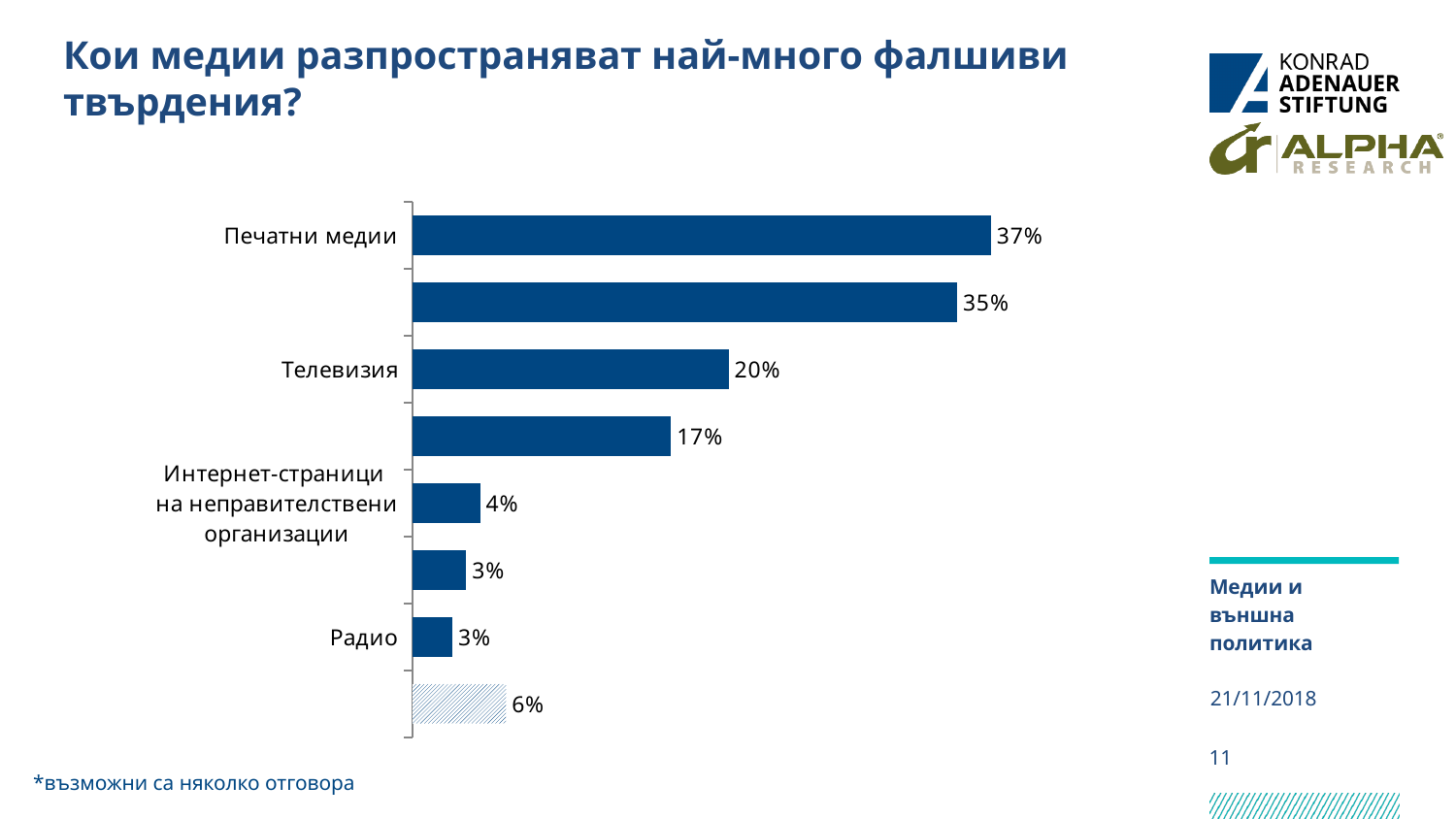
What is the value for Интернет-страници на неправителствени организации? 4% What is the difference between the values for Телевизия and Интернет-страници на неправителствени организации? 16 percentage points What is the value for Радио? 3% What kind of chart is shown on the slide? Bar chart How many bars are plotted in the chart? 8 What is the difference between the values for Печатни медии and Телевизия? 17 percentage points What is the value for Печатни медии? 37% Which is larger, the value for Печатни медии or the value for Интернет-страници на неправителствени организации? Печатни медии What is the value for Телевизия? 20% Which category has the highest value? Печатни медии What is the title of the slide? Кои медии разпространяват най-много фалшиви твърдения? Which is larger, the value for Телевизия or the value for Радио? Телевизия